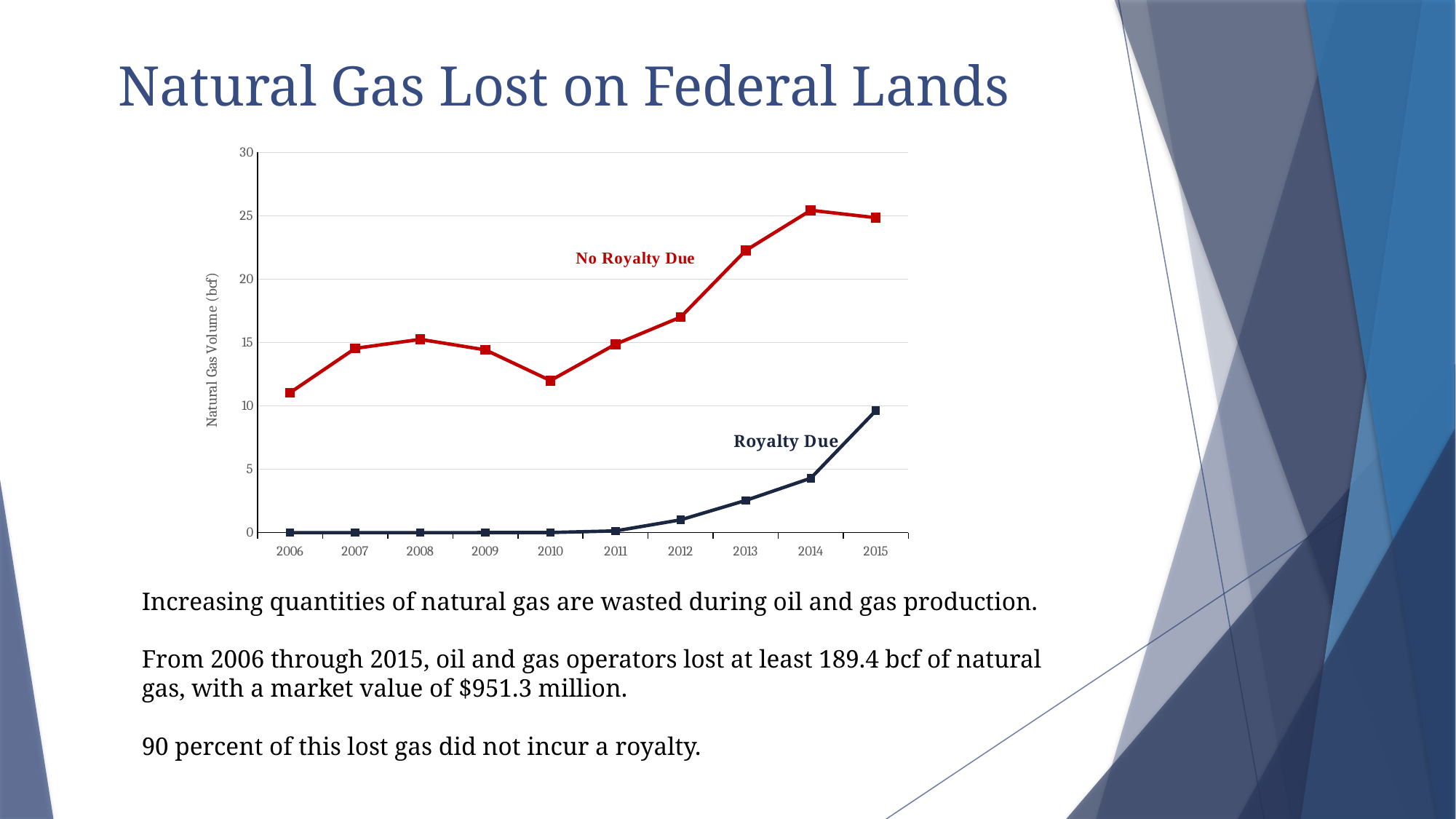
Which series has the larger value in 2012, No Royalty Due or Royalty Due? No Royalty Due In which year does the No Royalty Due series reach its highest value? 2014 Is the value for No Royalty Due in 2013 greater or less than 20? greater What is the label on the vertical axis of the chart? Natural Gas Volume (bcf) How many years are plotted along the x axis of the chart? 10 Is the value for No Royalty Due in 2010 greater or less than 15? less What kind of chart is shown on the slide? line chart How many data series are plotted in the chart? 2 Does the Royalty Due series rise or fall from 2011 to 2015? rise In which year does the Royalty Due series reach its highest value? 2015 In which year is the No Royalty Due series at its lowest value? 2006